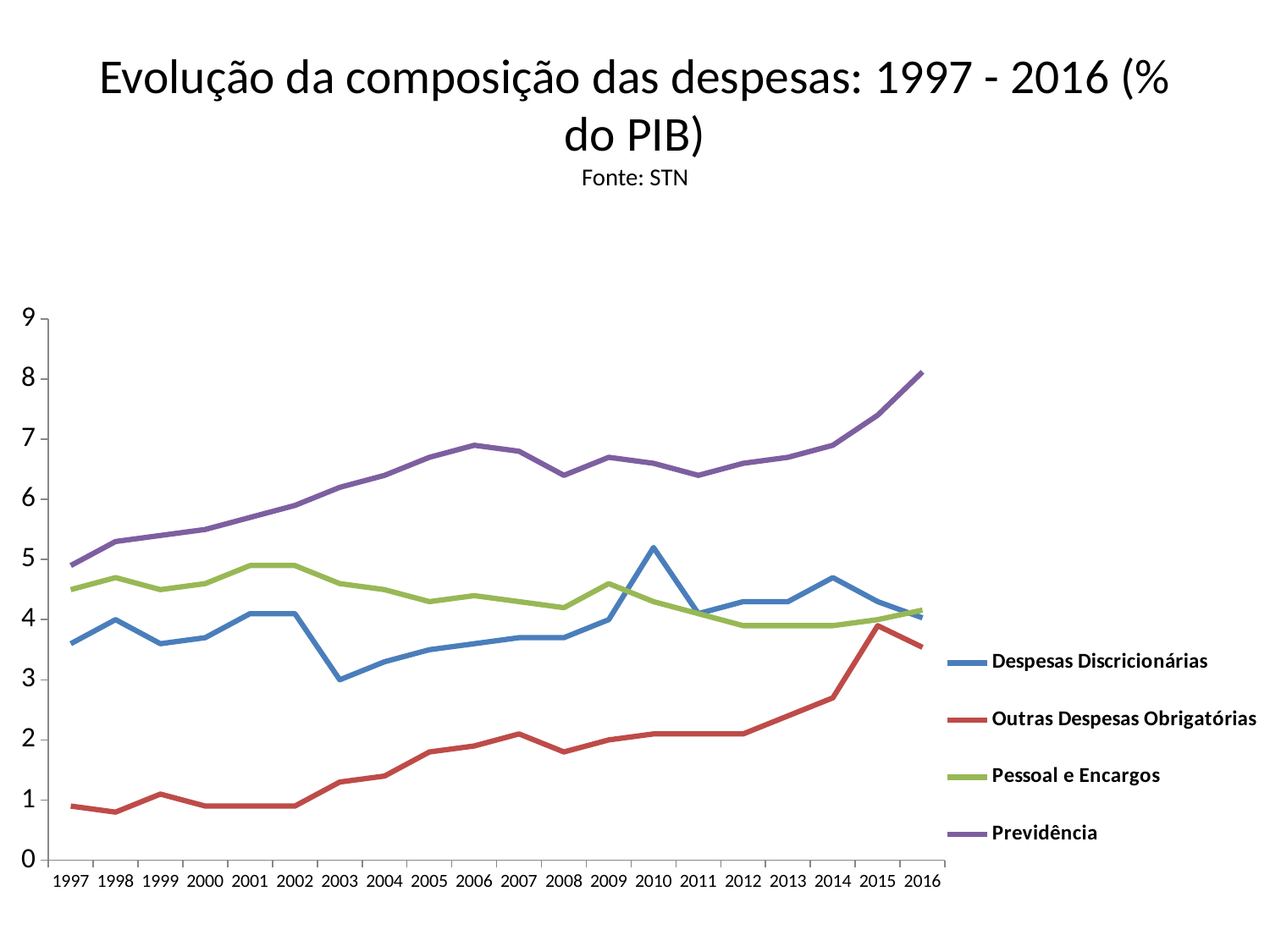
Does the Outras Despesas Obrigatórias series generally rise or fall from 1997 to 2016? rise Is the value for Despesas Discricionárias in 2010 greater or less than 5? greater What is the source cited below the chart title? STN What is the title of the chart? Evolução da composição das despesas: 1997 - 2016 (% do PIB) What kind of chart is shown on the slide? line chart How many years are plotted along the x axis? 20 Is the value for Previdência in 2016 greater or less than 7? greater How many series does the legend list? 4 In 2010, which is larger: Despesas Discricionárias or Pessoal e Encargos? Despesas Discricionárias Which series has the highest value in 2016? Previdência Which series has the lowest value in 1997? Outras Despesas Obrigatórias